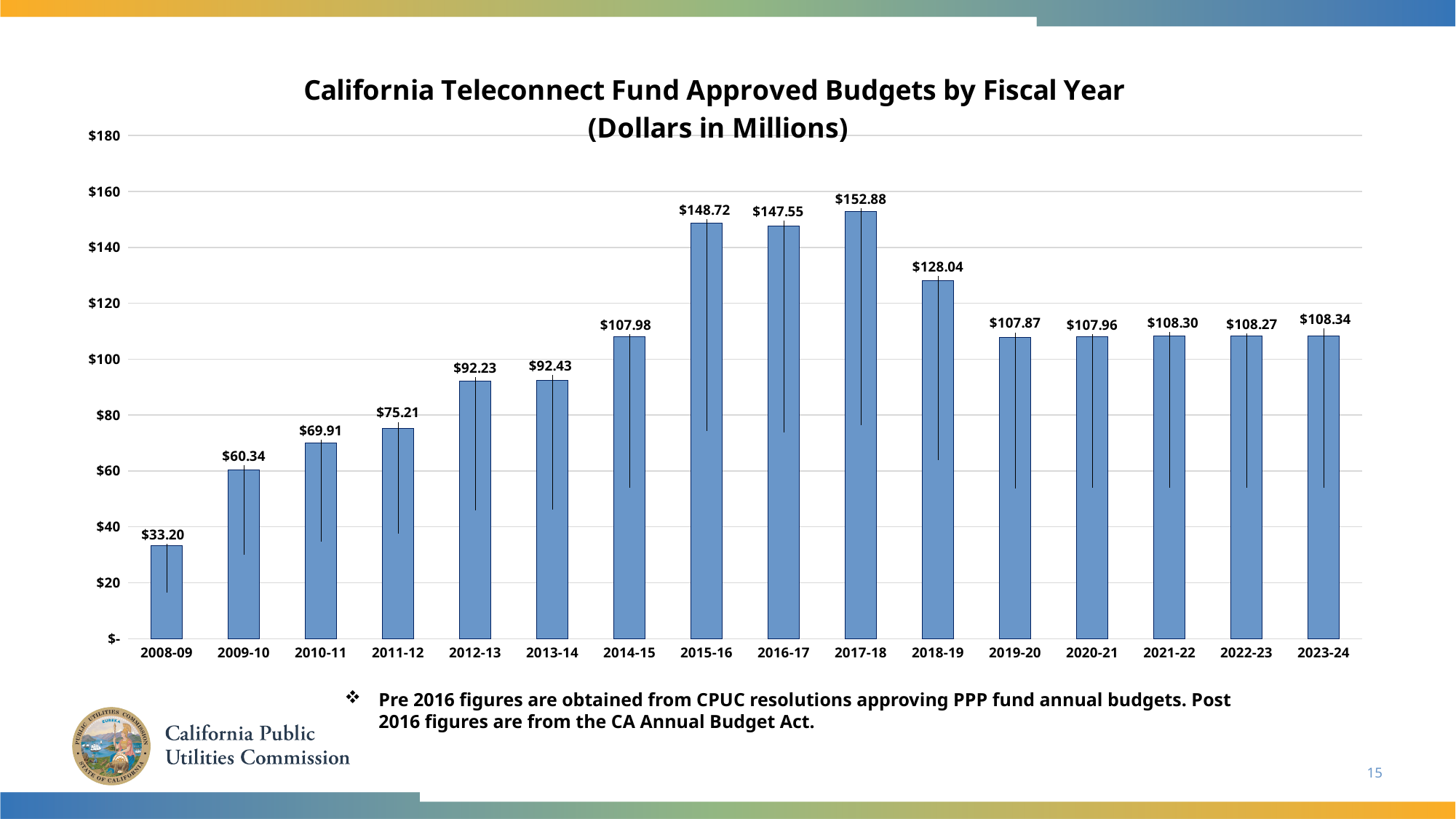
Which fiscal year has the highest approved budget? 2017-18 What kind of chart is shown on the slide? bar chart What is the approved budget for fiscal year 2023-24? $108.34 Which fiscal year has the larger approved budget, 2015-16 or 2016-17? 2015-16 Do the approved budgets rise or fall from 2008-09 to 2017-18? rise What is the approved budget for fiscal year 2015-16? $148.72 What is the approved budget for fiscal year 2008-09? $33.20 What is the title of the chart? California Teleconnect Fund Approved Budgets by Fiscal Year (Dollars in Millions) Is the value for 2018-19 greater or less than $120? greater Which fiscal year has the lowest approved budget? 2008-09 What is the difference between the approved budgets for 2017-18 and 2018-19? $24.84 How many fiscal years are shown on the x axis? 16